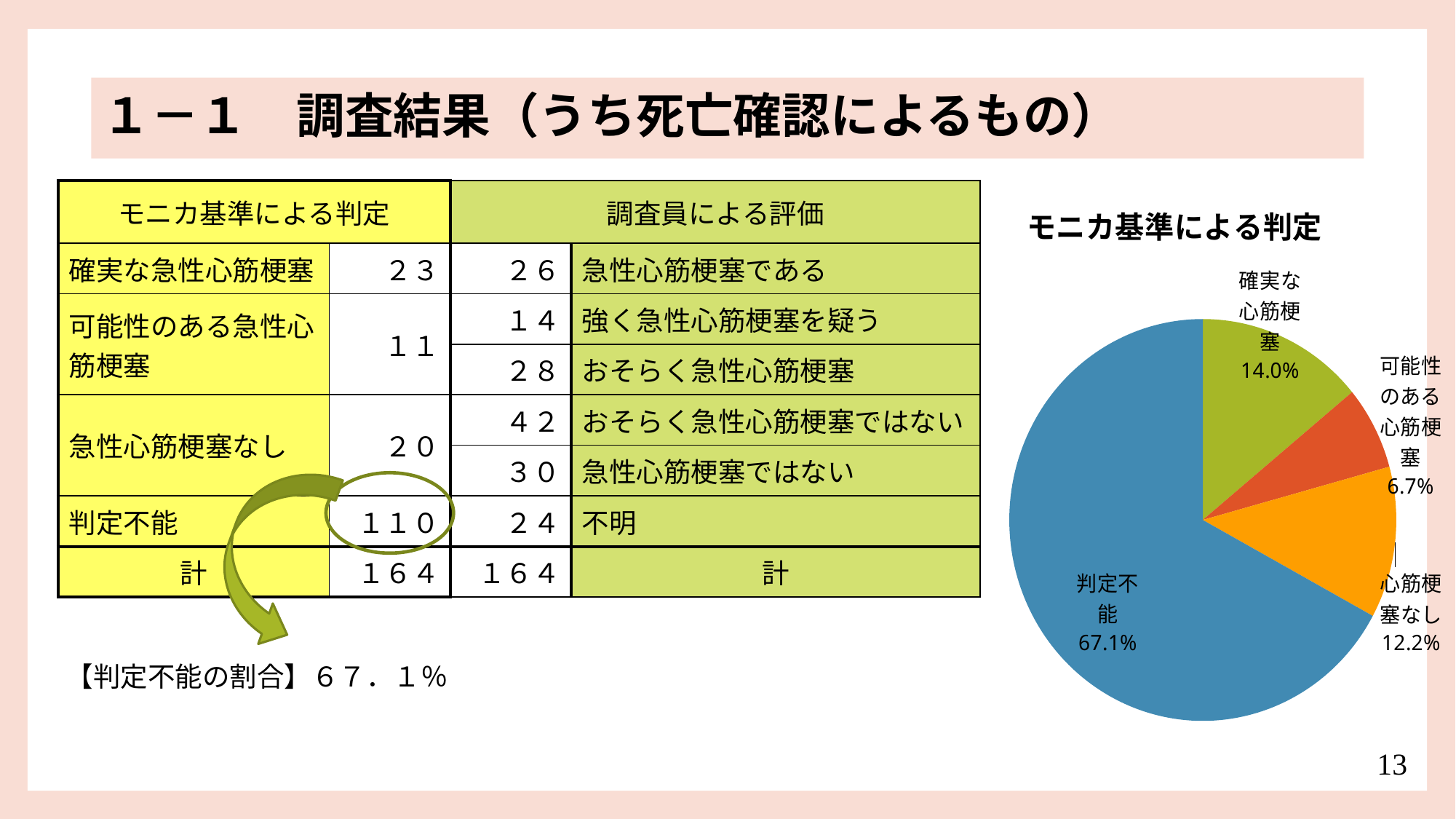
Which category has the smallest slice in the pie chart? 可能性のある心筋梗塞 What is the value shown for 心筋梗塞なし in the pie chart? 12.2% What kind of chart is shown on the slide? pie chart What is the difference in percentage points between 判定不能 and 確実な心筋梗塞 in the pie chart? 53.1 What share of the pie does 判定不能 take? 67.1% What is the title of the pie chart? モニカ基準による判定 Which is larger in the pie chart, 確実な心筋梗塞 or 心筋梗塞なし? 確実な心筋梗塞 How many slices does the pie chart have? 4 Which category has the largest slice in the pie chart? 判定不能 What colour is the 判定不能 slice in the pie chart? blue What is the value shown for 可能性のある心筋梗塞 in the pie chart? 6.7% What is the value shown for 確実な心筋梗塞 in the pie chart? 14.0%